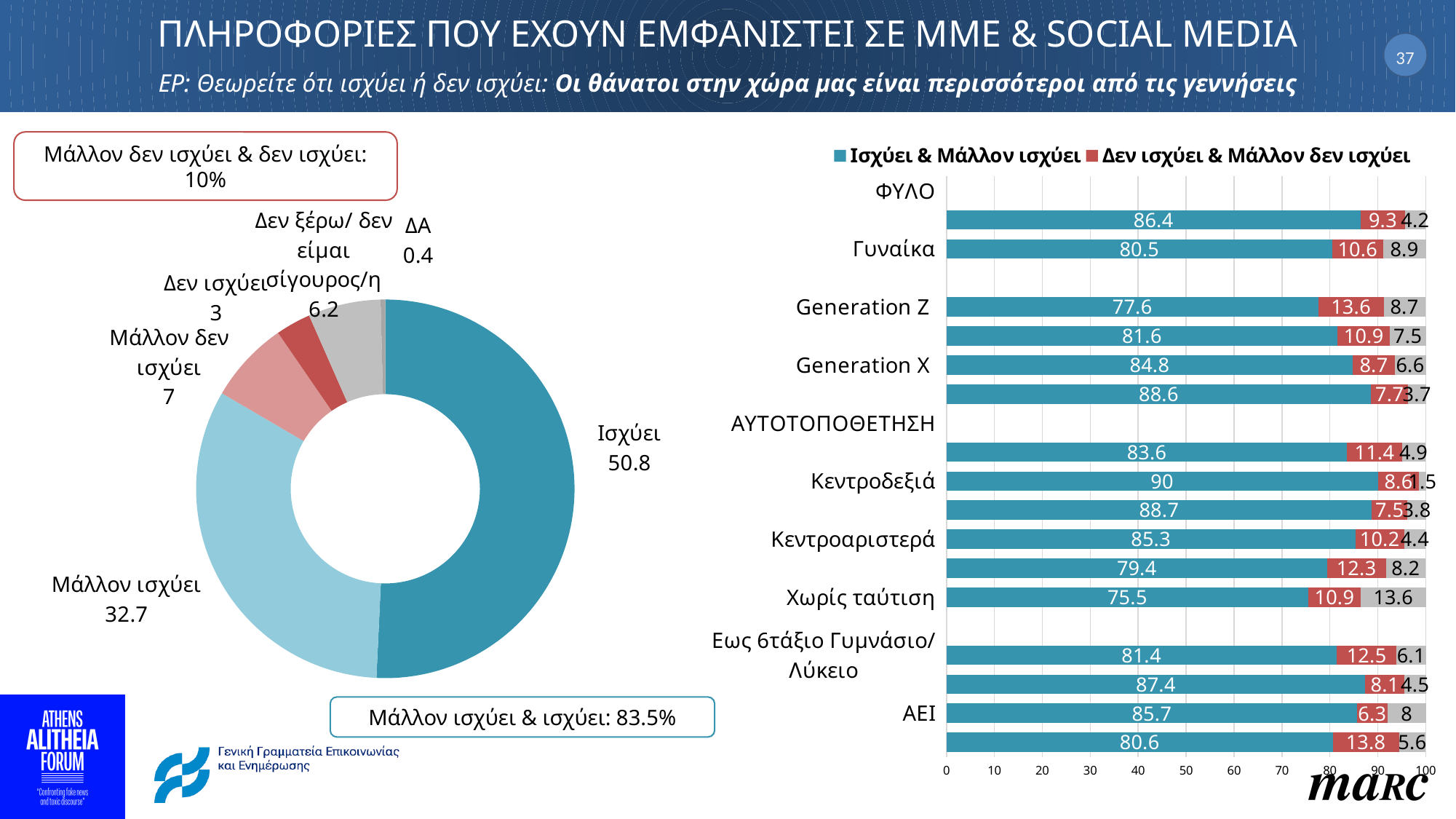
In the donut chart on the left, how many categories are shown? 6 What kind of chart is on the left of the slide? Pie (donut) chart In the donut chart on the left, which category has the smallest value? ΔΑ In the donut chart on the left, what is the difference between Ισχύει and Μάλλον ισχύει? 18.1 In the bar chart on the right, what is the Ισχύει & Μάλλον ισχύει value for Κεντροδεξιά? 90 In the bar chart on the right, which is larger for Ισχύει & Μάλλον ισχύει: Γυναίκα or Generation X? Generation X What kind of chart is on the right of the slide? Stacked horizontal bar chart In the donut chart on the left, what is the value for Ισχύει? 50.8 In the bar chart on the right, what is the difference in Ισχύει & Μάλλον ισχύει between Κεντροδεξιά and Χωρίς ταύτιση? 14.5 In the donut chart on the left, what is the value for Μάλλον ισχύει? 32.7 How many series does the legend of the bar chart on the right list? 2 In the bar chart on the right, what is the Δεν ισχύει & Μάλλον δεν ισχύει value for Generation Z? 13.6